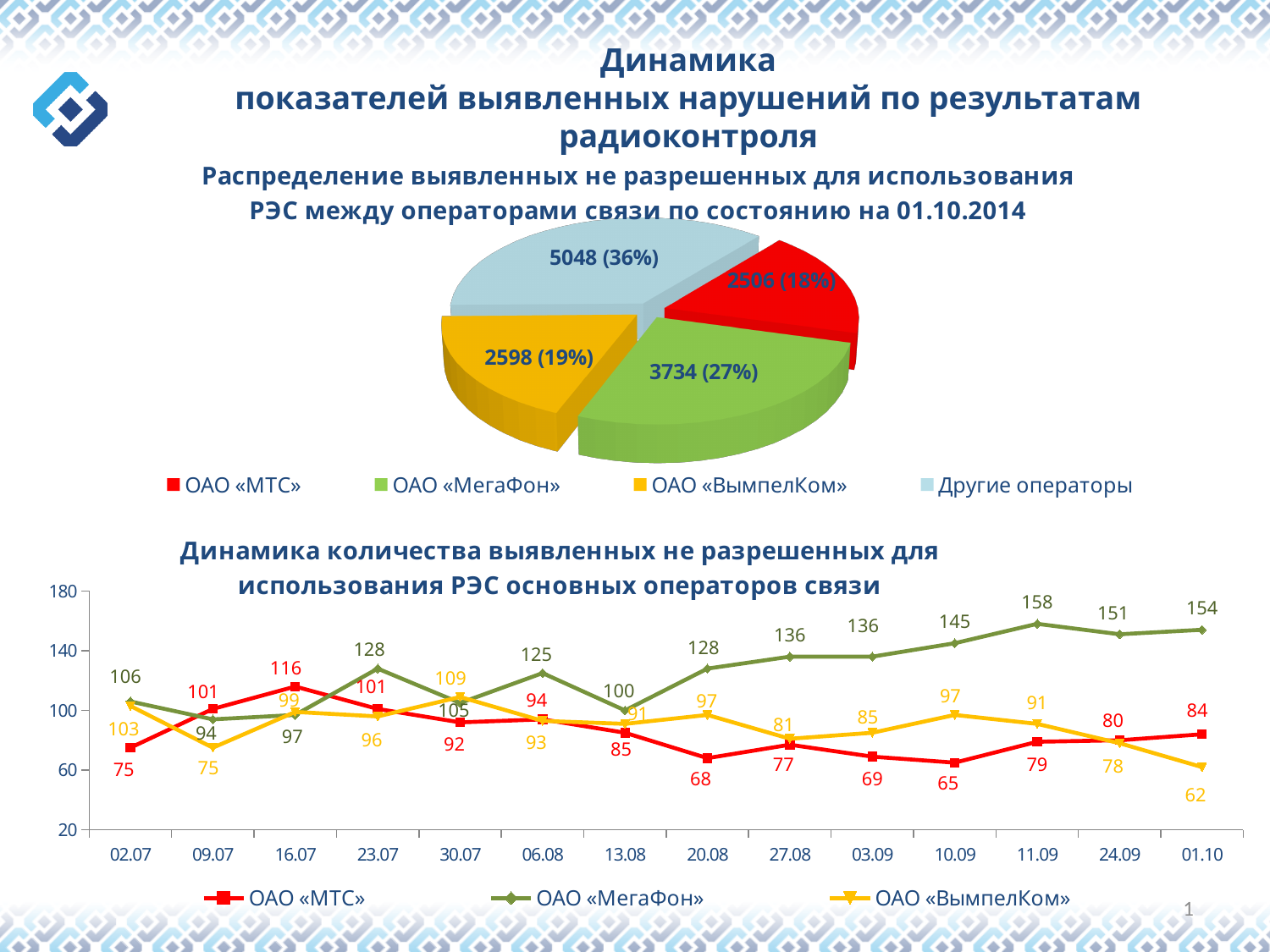
What kind of chart is the lower chart on the slide? Line chart In the pie chart, what is the difference between the values for ОАО «ВымпелКом» and ОАО «МТС»? 92 In the line chart, on which date does ОАО «ВымпелКом» reach its lowest value? 01.10 In the line chart, which is larger on 30.07: the value for ОАО «ВымпелКом» or for ОАО «МТС»? ОАО «ВымпелКом» How many series does the legend of the line chart list? 3 In the pie chart, what value is shown for ОАО «МегаФон»? 3734 (27%) In the line chart, what is the difference between ОАО «МегаФон» and ОАО «МТС» on 01.10? 70 In the pie chart, what share of the total do Другие операторы account for? 36% In the pie chart, which operator has the smallest slice? ОАО «МТС» In the line chart, what is the value for ОАО «МегаФон» on 11.09? 158 In the line chart, what is the value for ОАО «МТС» on 16.07? 116 How many dates are shown on the x axis of the line chart? 14